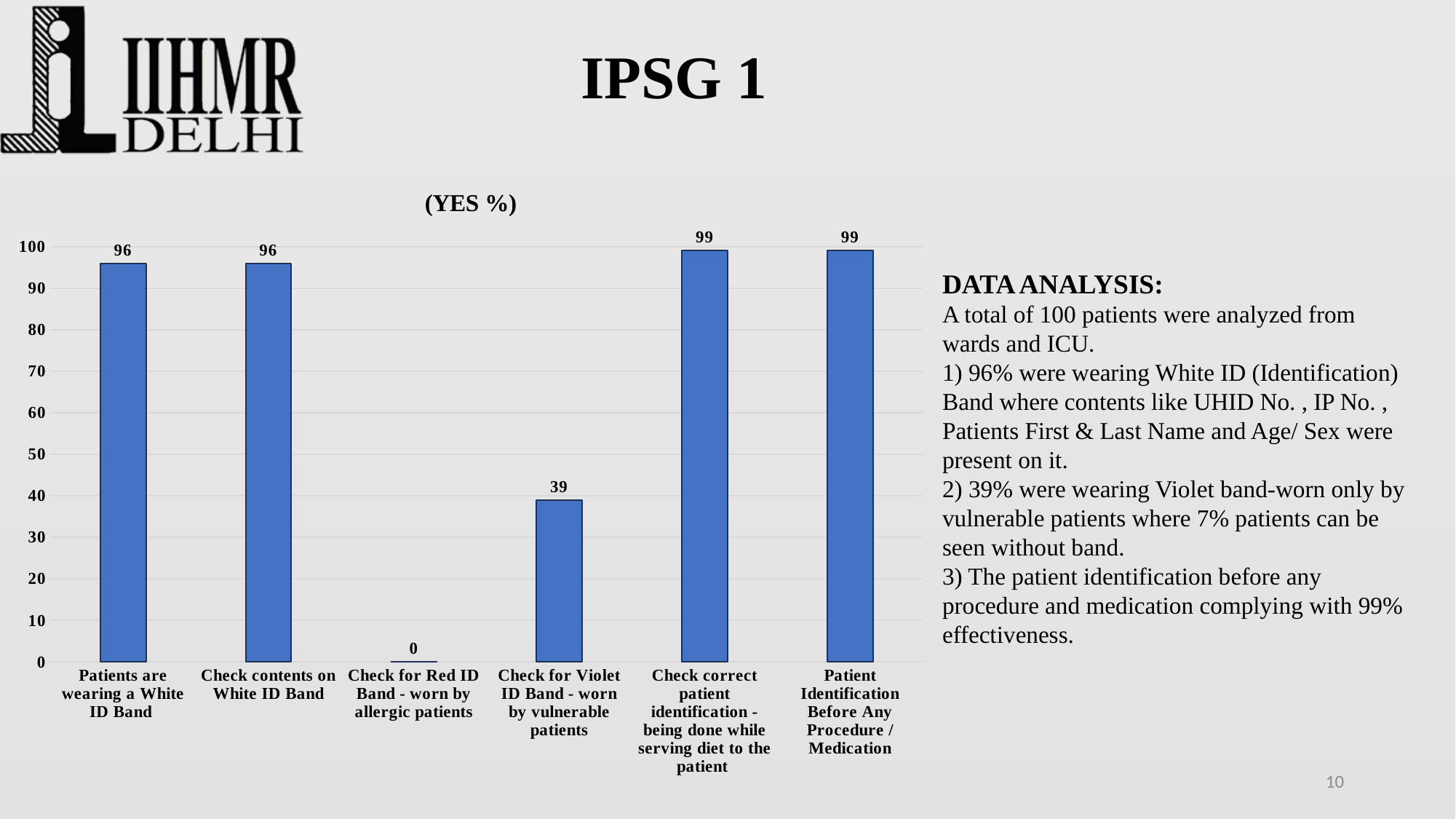
Which category has the lowest value? Check for Red ID Band - worn by allergic patients What is the value for 'Patient Identification Before Any Procedure / Medication'? 99 What is the difference between the values for 'Check correct patient identification - being done while serving diet to the patient' and 'Check for Violet ID Band - worn by vulnerable patients'? 60 What is the value for 'Check for Red ID Band - worn by allergic patients'? 0 What is the title of the chart? (YES %) Is the value for 'Check for Violet ID Band - worn by vulnerable patients' greater or less than 50? less What kind of chart is shown on the slide? bar chart Which is larger: the value for 'Check contents on White ID Band' or the value for 'Check for Violet ID Band - worn by vulnerable patients'? Check contents on White ID Band What is the value for 'Patients are wearing a White ID Band'? 96 What is the value for 'Check for Violet ID Band - worn by vulnerable patients'? 39 What is the difference between the values for 'Patients are wearing a White ID Band' and 'Patient Identification Before Any Procedure / Medication'? 3 How many categories are shown on the chart? 6